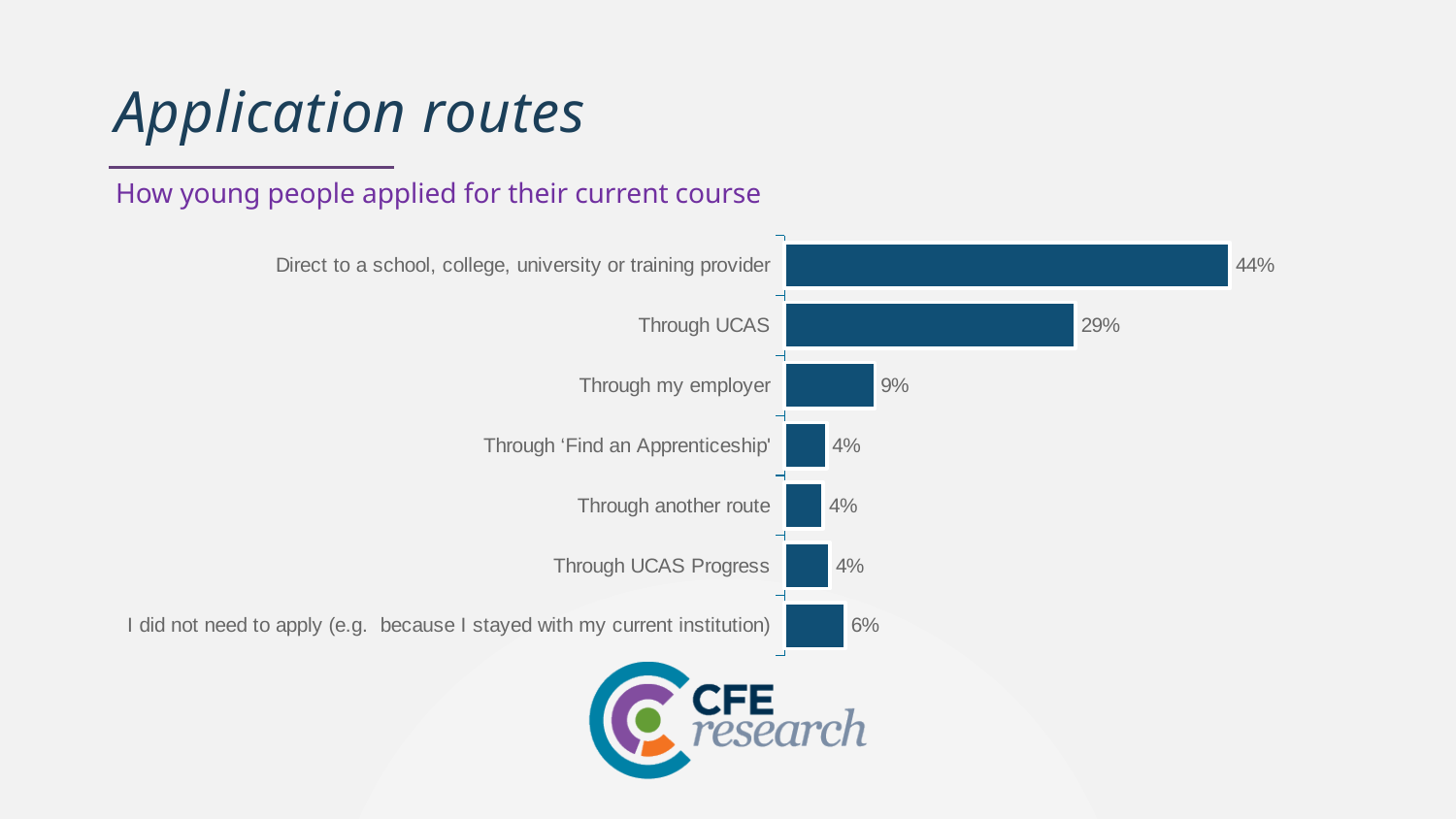
What is the subtitle of the chart on the slide? How young people applied for their current course What is the difference in percentage points between applying direct to a provider and applying through UCAS? 15 What percentage of young people did not need to apply because they stayed with their current institution? 6% Which is larger: the percentage who did not need to apply or the percentage who applied through UCAS Progress? I did not need to apply What percentage of young people applied through UCAS? 29% Which is larger: the percentage who applied through UCAS or the percentage who applied through their employer? Through UCAS What percentage of young people applied through their employer? 9% What type of chart is used to show how young people applied for their current course? Bar chart What is the difference in percentage points between applying through my employer and applying through 'Find an Apprenticeship'? 5 Which application route has the highest percentage? Direct to a school, college, university or training provider How many application routes are shown in the chart? 7 What percentage of young people applied direct to a school, college, university or training provider? 44%